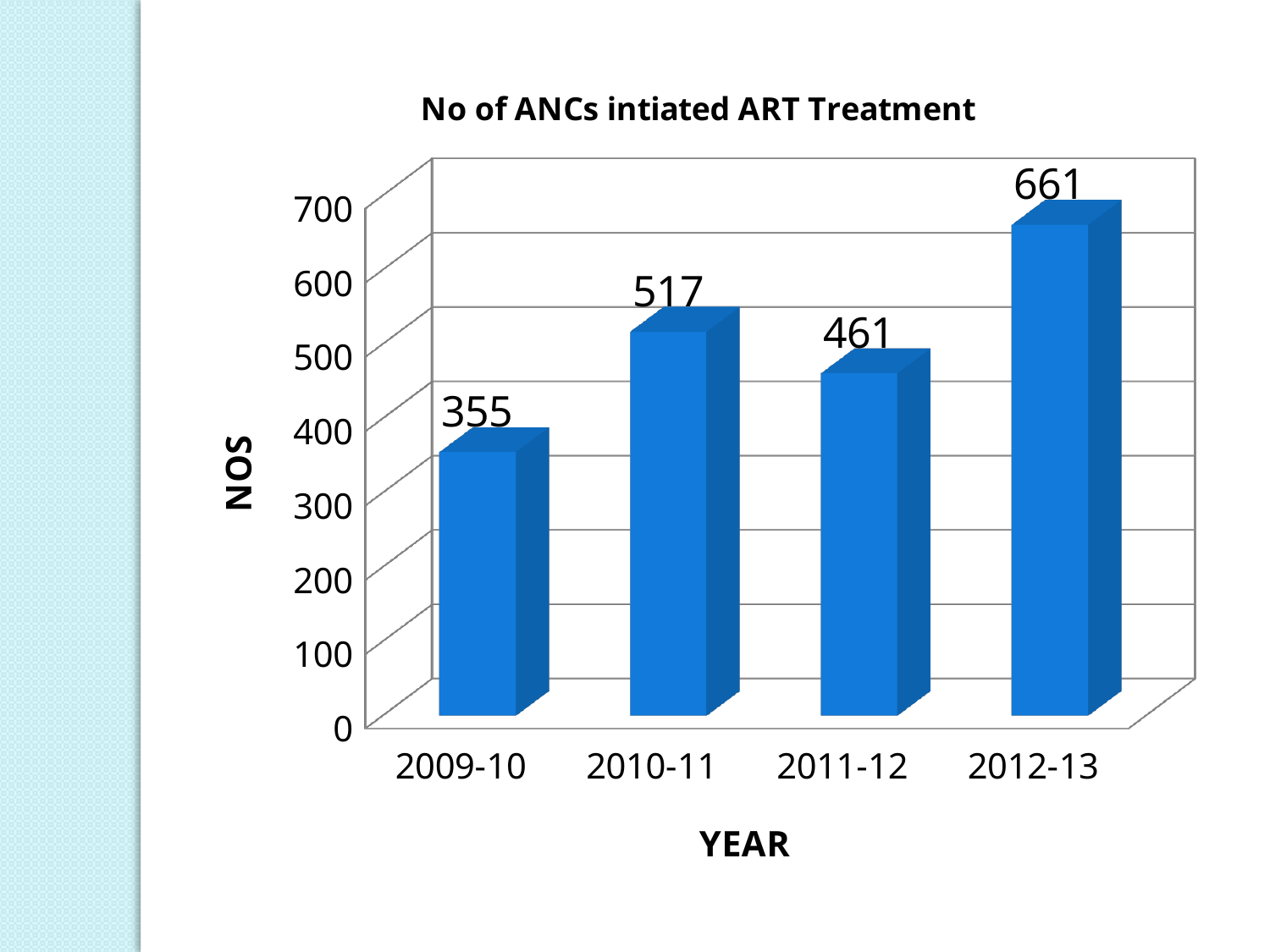
What is the value for 2012-13? 661 What is the title of the chart? No of ANCs intiated ART Treatment What is the value for 2009-10? 355 What kind of chart is shown on the slide? bar chart Is the value for 2012-13 greater or less than 600? greater Which year has the lowest value? 2009-10 What is the difference between the values for 2012-13 and 2009-10? 306 What is the difference between the values for 2010-11 and 2011-12? 56 Which is larger, the value for 2010-11 or the value for 2011-12? 2010-11 How many years are shown on the x axis? 4 What is the value for 2011-12? 461 Which year has the highest number of ANCs initiated on ART treatment? 2012-13